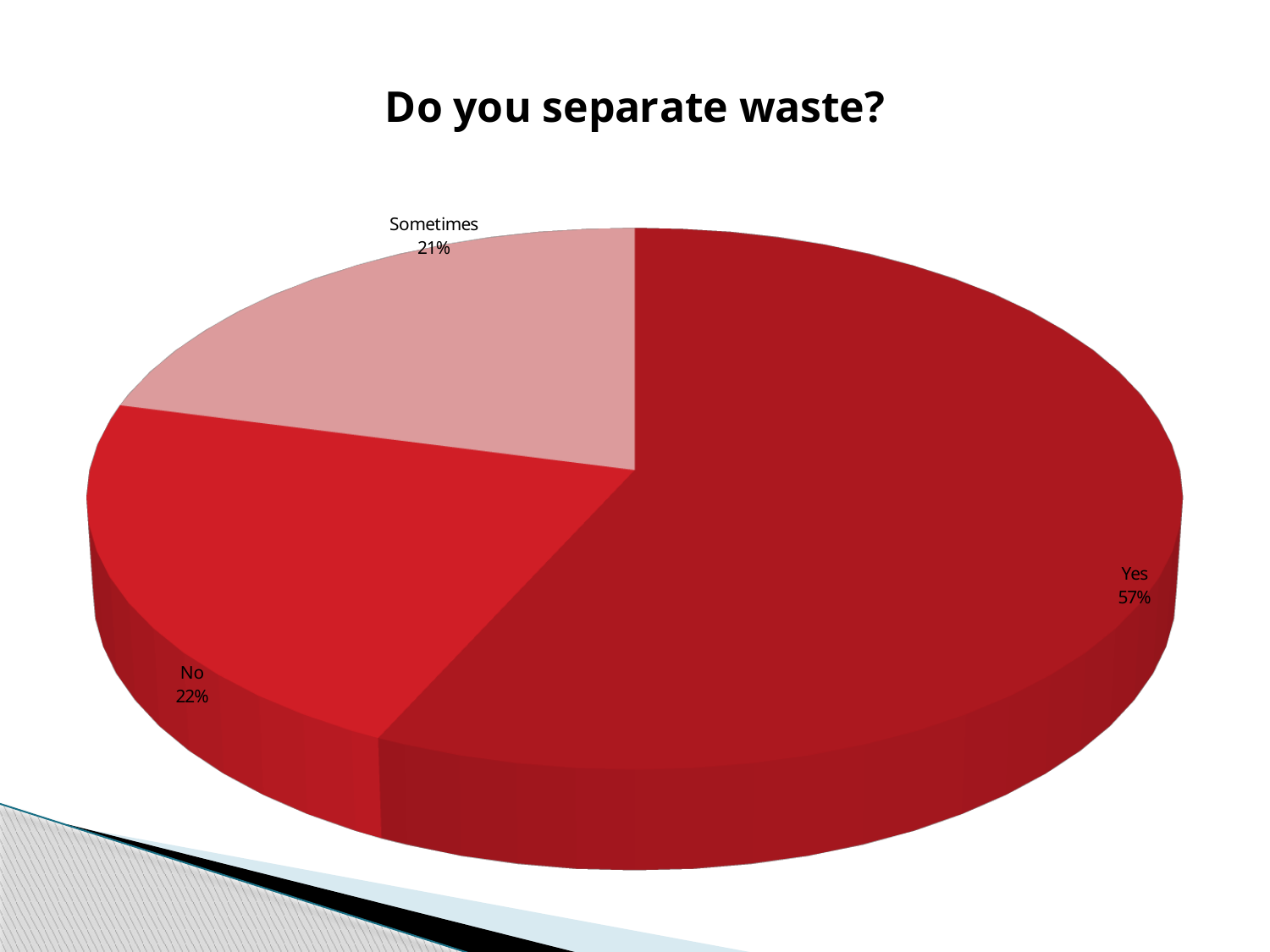
What kind of chart is shown on the slide? Pie chart What percentage of respondents answered "No"? 22% What percentage of respondents answered "Yes" to separating waste? 57% Which response has the smallest share of the pie? Sometimes What is the difference in percentage points between the "No" and "Sometimes" responses? 1 What is the combined share of the "No" and "Sometimes" responses? 43% Which response has the largest share of the pie? Yes How many slices does the pie chart have? 3 Which is larger, the share for "Yes" or the share for "Sometimes"? Yes What is the title of the chart? Do you separate waste? What percentage of respondents answered "Sometimes"? 21% What is the difference in percentage points between the "Yes" and "No" responses? 35